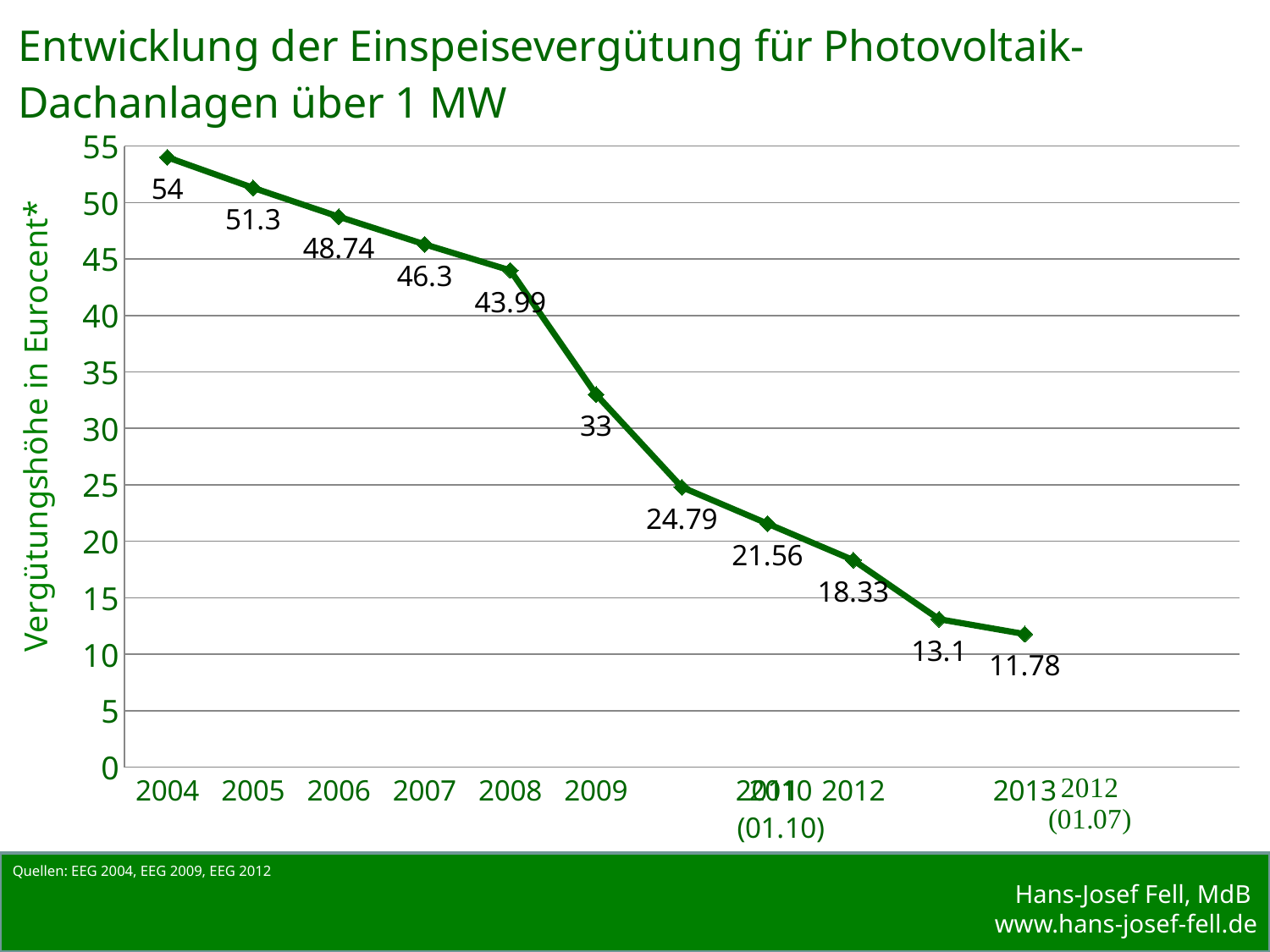
Which is larger, the value for 2007 or the value for 2009? 2007 What is the difference between the values for 2004 and 2005? 2.7 Which year has the highest value? 2004 What is the value of the last (rightmost) data point on the line? 11.78 Do the values rise or fall from left to right along the x axis? fall What is the value for 2006? 48.74 What is the value for 2009? 33 What is the value for 2008? 43.99 What kind of chart is shown? line chart What is the value for 2004? 54 What is the lowest value shown on the line? 11.78 How many data points are plotted on the line? 11